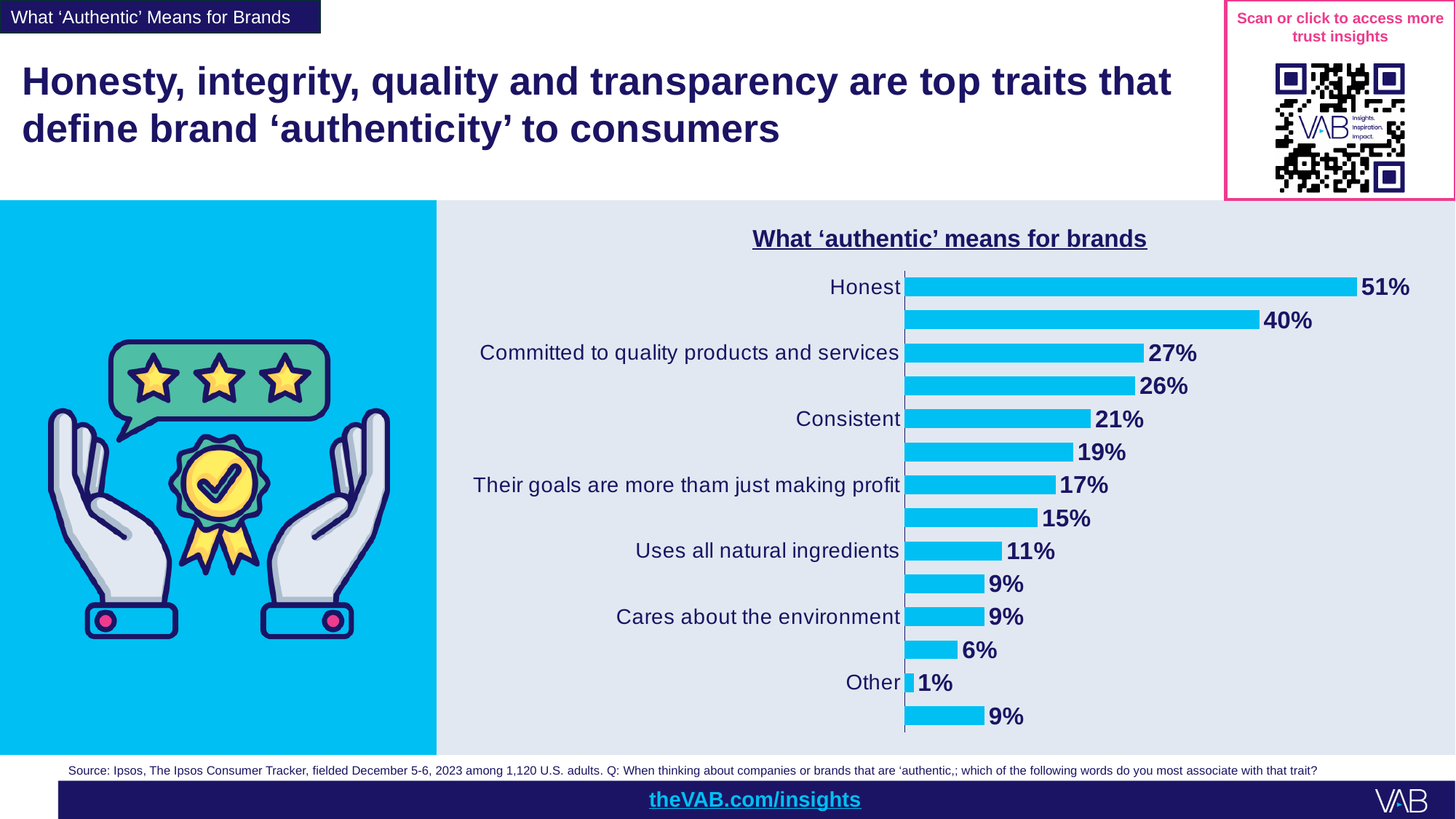
What percentage is shown for 'Honest' in the chart? 51% How many bars are plotted in the chart? 14 What is the difference between the values for 'Honest' and 'Consistent'? 30% What value is shown for 'Their goals are more tham just making profit'? 17% What percentage is shown for 'Consistent'? 21% Which category has the highest value in the chart? Honest What value does the chart show for 'Cares about the environment'? 9% Which category has the lowest value in the chart? Other Which is larger: the value for 'Uses all natural ingredients' or the value for 'Cares about the environment'? Uses all natural ingredients What percentage is shown for 'Uses all natural ingredients'? 11% What type of chart is shown on the slide? Bar chart What value does the chart show for 'Committed to quality products and services'? 27%